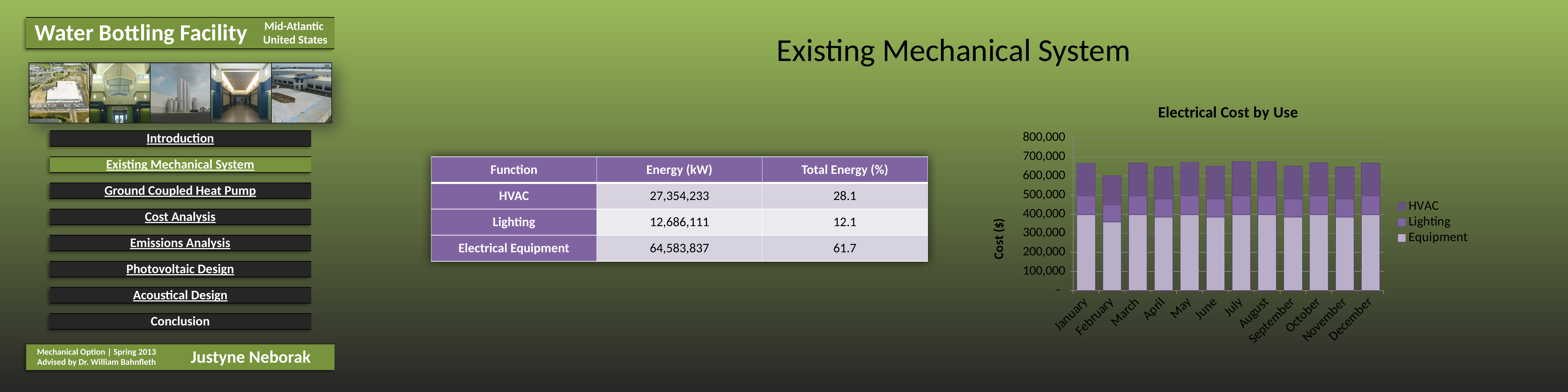
How many months are shown on the x axis of the "Electrical Cost by Use" chart? 12 Which is larger in the "Electrical Cost by Use" chart: the total cost for January or the total cost for February? January Is the Equipment cost for February greater or less than 400,000? less Is the total electrical cost for January greater or less than 600,000? greater What are the three series listed in the legend of the "Electrical Cost by Use" chart? HVAC, Lighting, Equipment Which month has the lowest total electrical cost in the "Electrical Cost by Use" chart? February How many series does the legend of the "Electrical Cost by Use" chart list? 3 Is the total electrical cost for February greater or less than 700,000? less Which series forms the bottom segment of each stacked bar in the "Electrical Cost by Use" chart? Equipment What kind of chart is the "Electrical Cost by Use" chart? Stacked bar chart What is the label on the y axis of the "Electrical Cost by Use" chart? Cost ($)